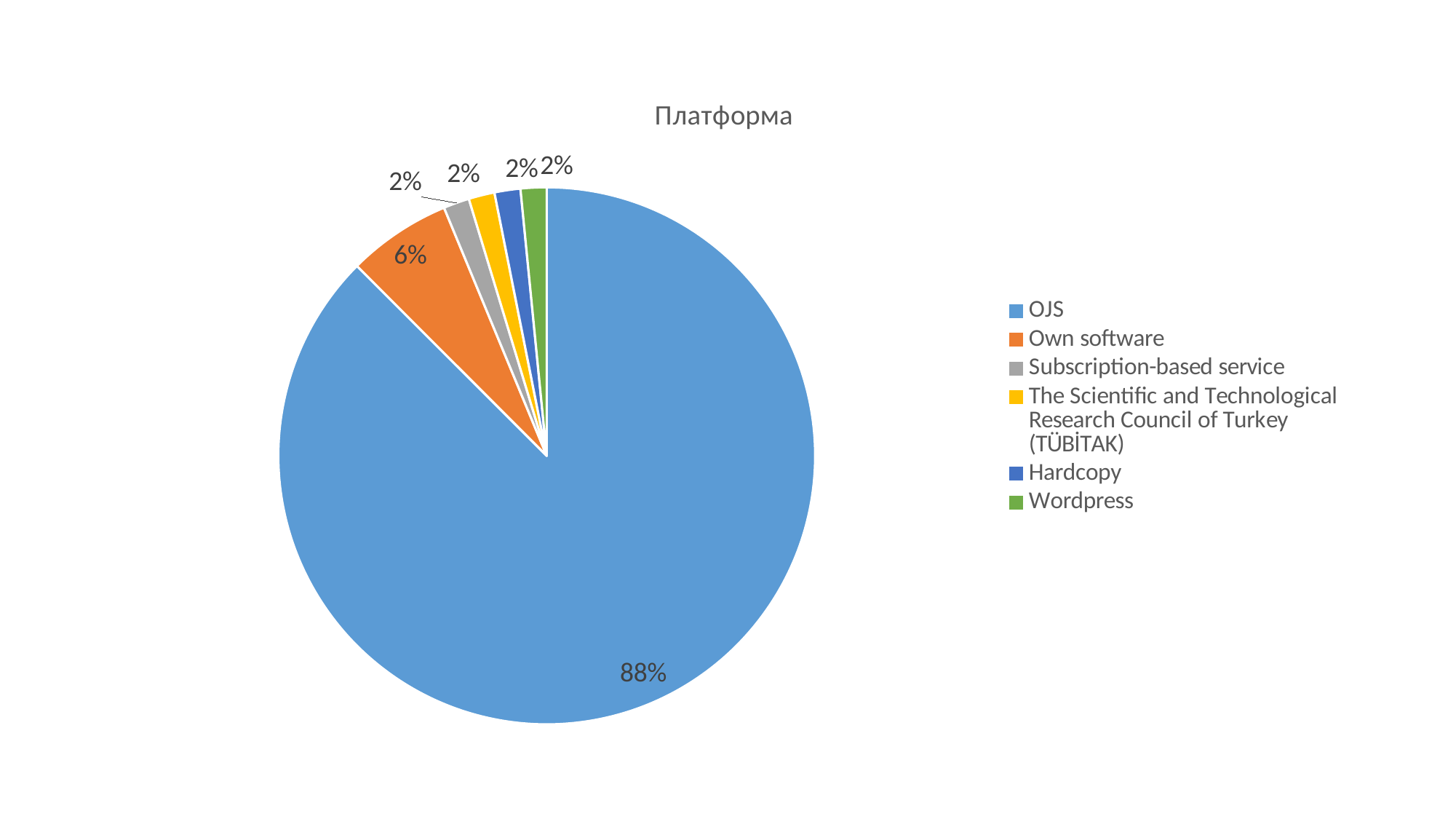
Which category has the largest slice of the pie? OJS How many categories does the pie chart show? 6 What is the combined share of Own software and Subscription-based service? 8% What share of the pie does OJS hold? 88% What share of the pie does Own software hold? 6% What share of the pie does Wordpress hold? 2% What is the difference between the OJS share and the Own software share? 82% Which colour represents Hardcopy in the pie chart? Blue What kind of chart is shown on the slide? Pie chart Which is larger, the share for Own software or the share for Subscription-based service? Own software What is the title of the chart? Платформа